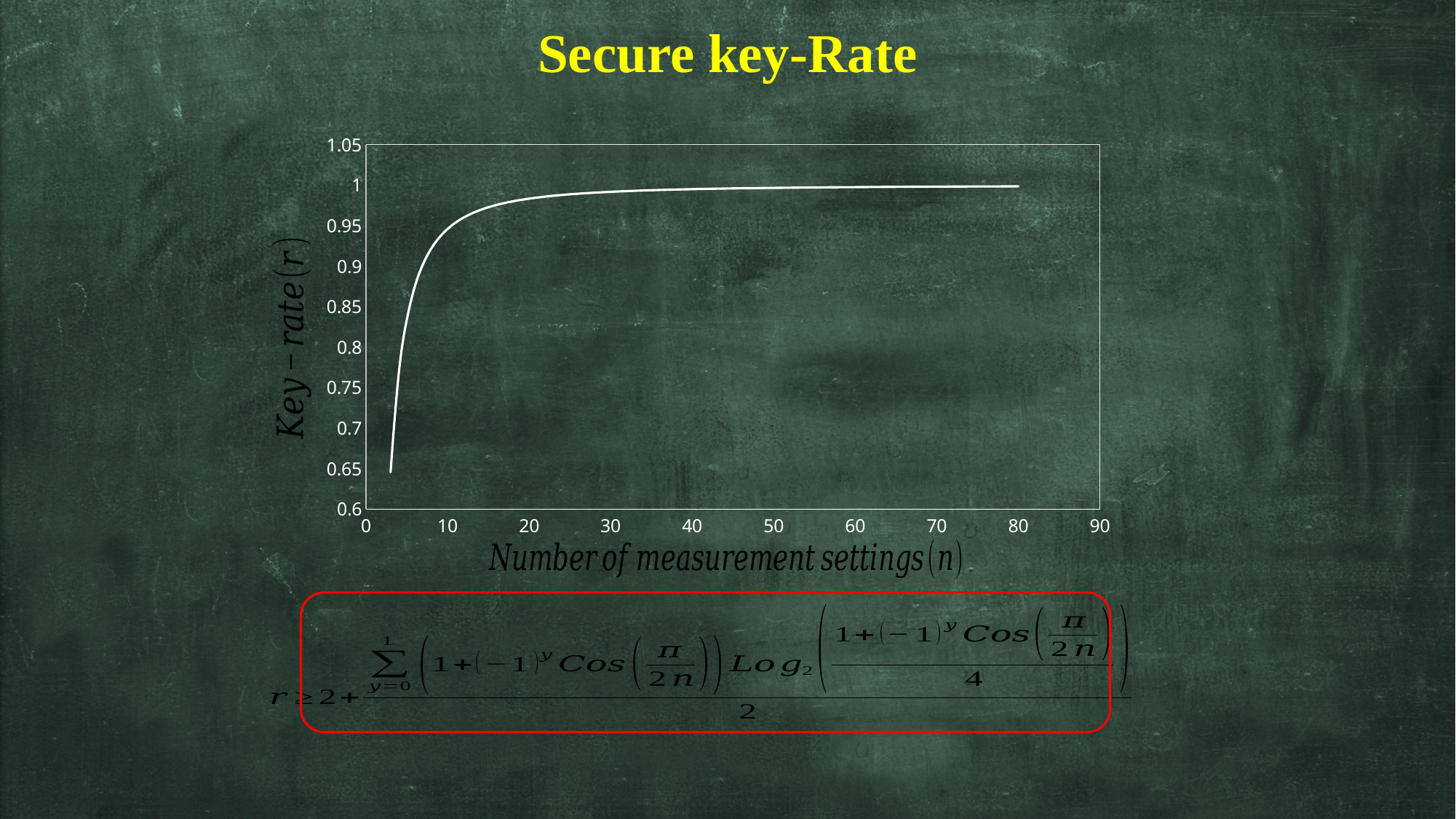
What kind of chart is shown on the slide? line chart What is the label of the x axis of the chart? Number of measurement settings (n) Is the key-rate at the leftmost point of the curve greater or less than 0.7? less What is the title of the slide containing the chart? Secure key-Rate What is the lowest tick value shown on the y axis? 0.6 Does the key-rate rise or fall as the number of measurement settings increases? rise Is the key-rate at 10 measurement settings greater or less than 0.9? greater What is the highest tick value shown on the x axis? 90 Is the key-rate at 40 measurement settings greater or less than 0.95? greater What is the highest tick value shown on the y axis? 1.05